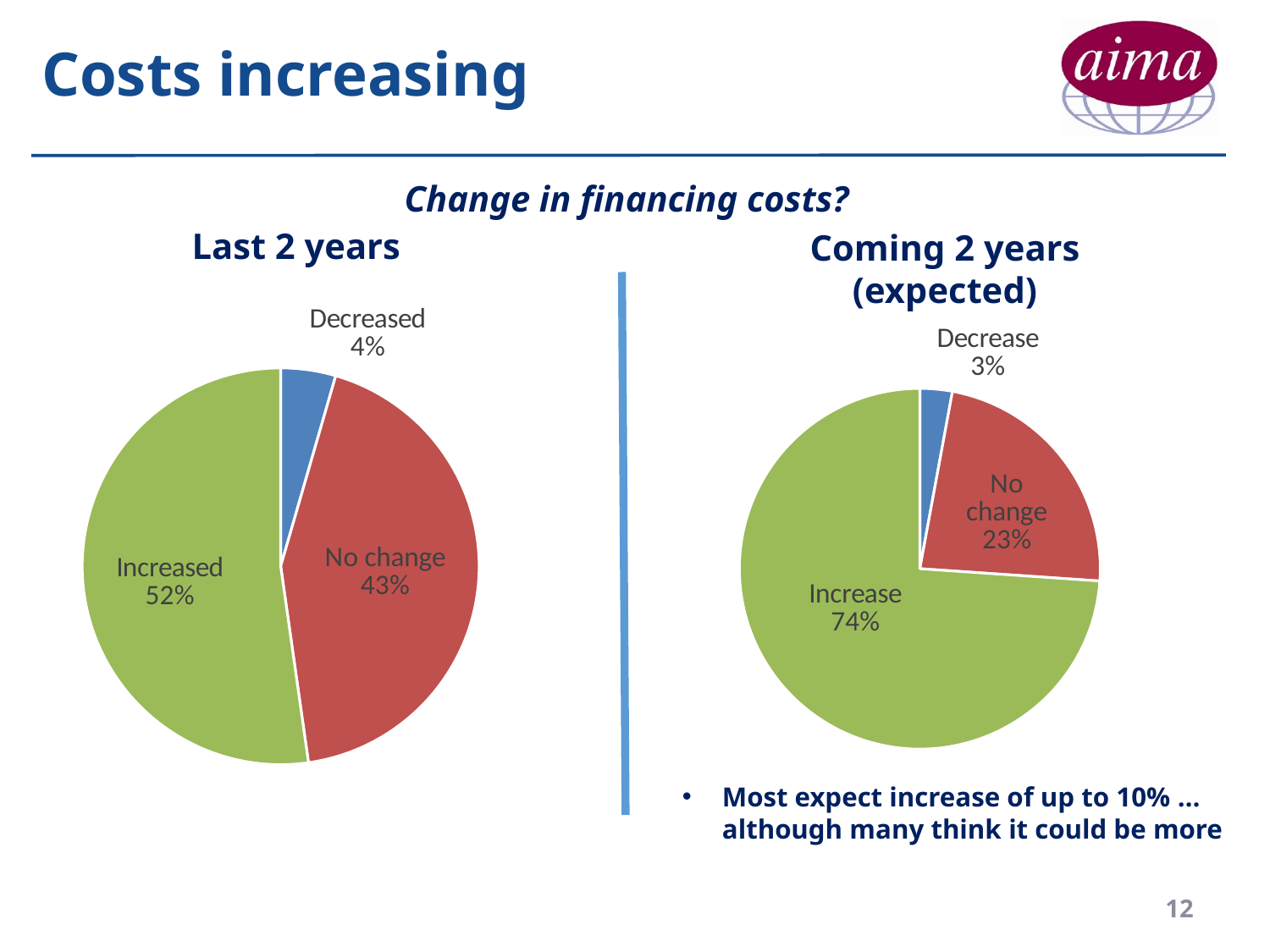
In the 'Last 2 years' pie chart, what share of respondents said costs increased? 52% In the 'Coming 2 years (expected)' pie chart, what percentage expect a decrease? 3% In the 'Last 2 years' pie chart, what is the difference between the 'Increased' and 'No change' shares? 9 percentage points Which is larger: 'No change' in the 'Last 2 years' chart or 'No change' in the 'Coming 2 years (expected)' chart? Last 2 years What type of chart is used on the left side of the slide for 'Last 2 years'? Pie chart How many slices does the 'Coming 2 years (expected)' pie chart have? 3 What is the difference between the 'Increased' share in the 'Last 2 years' chart and the 'Increase' share in the 'Coming 2 years (expected)' chart? 22 percentage points In the 'Last 2 years' pie chart, which category has the smallest share? Decreased What colour is the 'Increase' slice in the 'Coming 2 years (expected)' pie chart? Green In the 'Coming 2 years (expected)' pie chart, what percentage expect an increase? 74% In the 'Coming 2 years (expected)' pie chart, which category has the largest share? Increase In the 'Last 2 years' pie chart, what percentage is shown for 'No change'? 43%